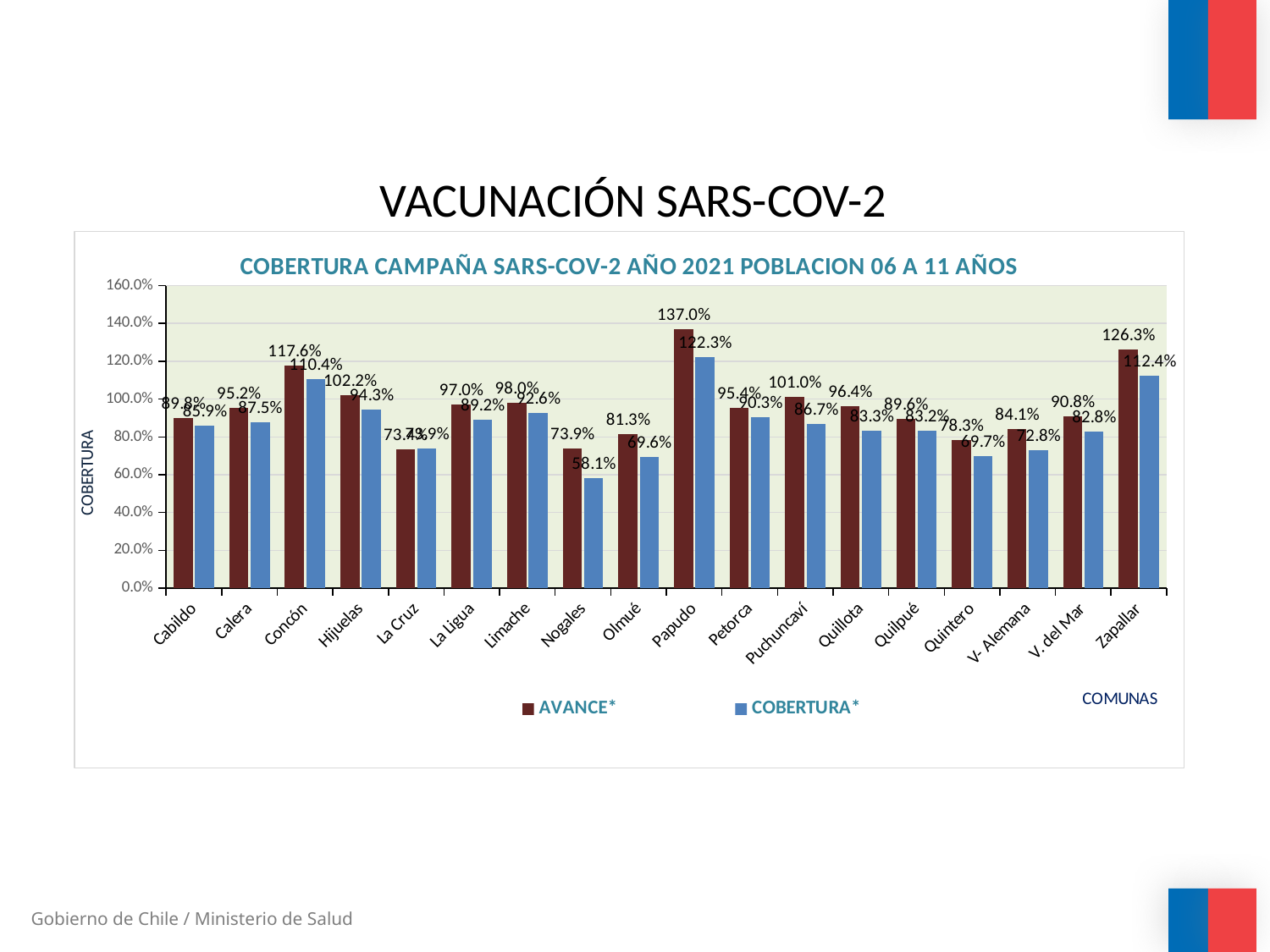
Which comuna has the lowest COBERTURA* value? Nogales Is the COBERTURA* value for Olmué greater or less than 80%? less How many series does the legend list? 2 What is the AVANCE* value for Puchuncaví? 101.0% What is the AVANCE* value for Papudo? 137.0% Which has a higher AVANCE* value, Concón or Zapallar? Zapallar What is the COBERTURA* value for Nogales? 58.1% What is the COBERTURA* value for Zapallar? 112.4% What kind of chart is shown on the slide? bar chart Which comuna has the highest AVANCE* value? Papudo What is the difference between the AVANCE* and COBERTURA* values for Papudo? 14.7 percentage points How many comunas are shown on the x axis? 18